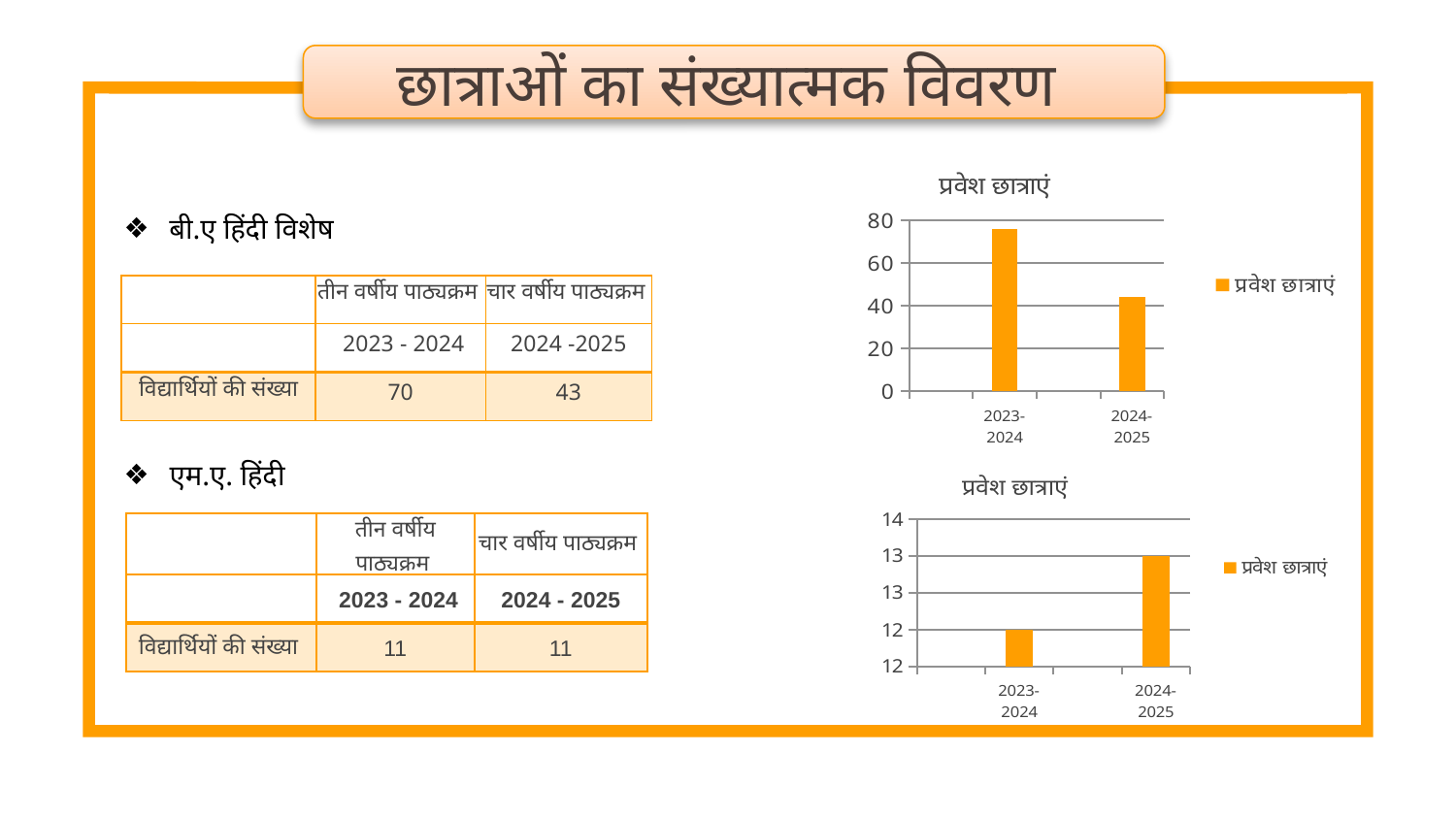
What kind of chart is the top chart on the slide? bar chart In the top chart, do the values rise or fall from 2023-2024 to 2024-2025? fall In the top chart, is the value for 2023-2024 greater or less than 60? greater In the top chart, which category has the lowest bar? 2024-2025 In the bottom chart, which category has the higher bar, 2023-2024 or 2024-2025? 2024-2025 In the top chart, is the value for 2024-2025 greater or less than 60? less In the top chart, how many categories are shown on the x axis? 2 In the top chart, which category has the highest bar? 2023-2024 In the bottom chart, how many bars are plotted? 2 What kind of chart is the bottom chart on the slide? bar chart How many series does the legend of the top chart list? 1 In the bottom chart, do the values rise or fall from 2023-2024 to 2024-2025? rise